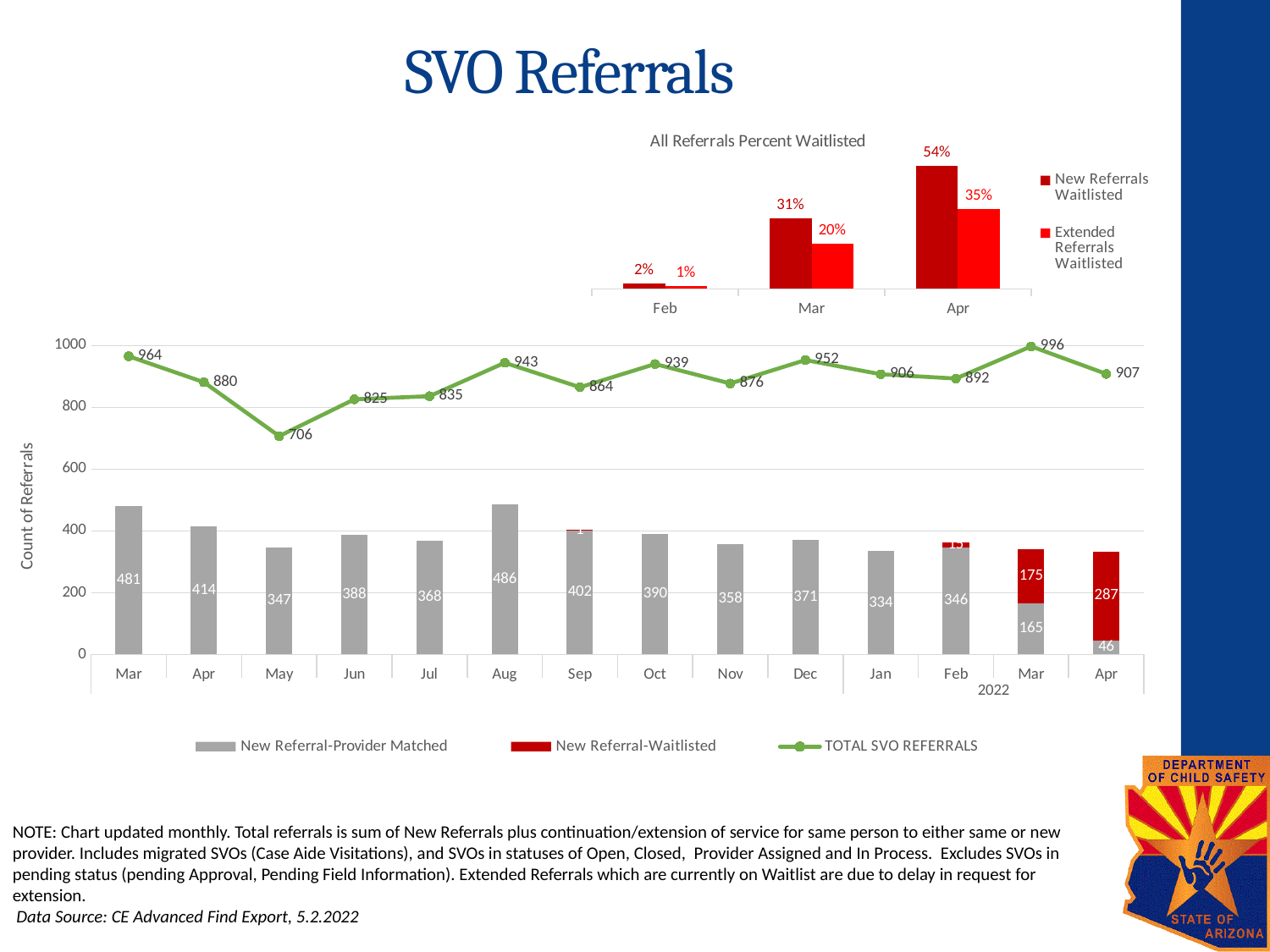
In the main SVO Referrals chart, what is the TOTAL SVO REFERRALS value for May? 706 In the main SVO Referrals chart, what colour is the TOTAL SVO REFERRALS line? Green In the 'All Referrals Percent Waitlisted' chart, what is the New Referrals Waitlisted value for Apr? 54% In the main SVO Referrals chart, what is the New Referral-Waitlisted value for Apr 2022? 287 In the main SVO Referrals chart, what is the difference between the TOTAL SVO REFERRALS values for Mar 2022 and Apr 2022? 89 In the main SVO Referrals chart, which month has the highest TOTAL SVO REFERRALS value? Mar 2022 In the main SVO Referrals chart, how many months are shown on the x axis? 14 In the 'All Referrals Percent Waitlisted' chart, which month has the lowest New Referrals Waitlisted percentage? Feb In the 'All Referrals Percent Waitlisted' chart, what is the Extended Referrals Waitlisted value for Mar? 20% In the main SVO Referrals chart, which is larger: the New Referral-Provider Matched value for Mar 2022 or the New Referral-Waitlisted value for Mar 2022? New Referral-Waitlisted In the 'All Referrals Percent Waitlisted' chart, how many series does the legend list? 2 In the main SVO Referrals chart, what is the New Referral-Provider Matched value for Aug? 486